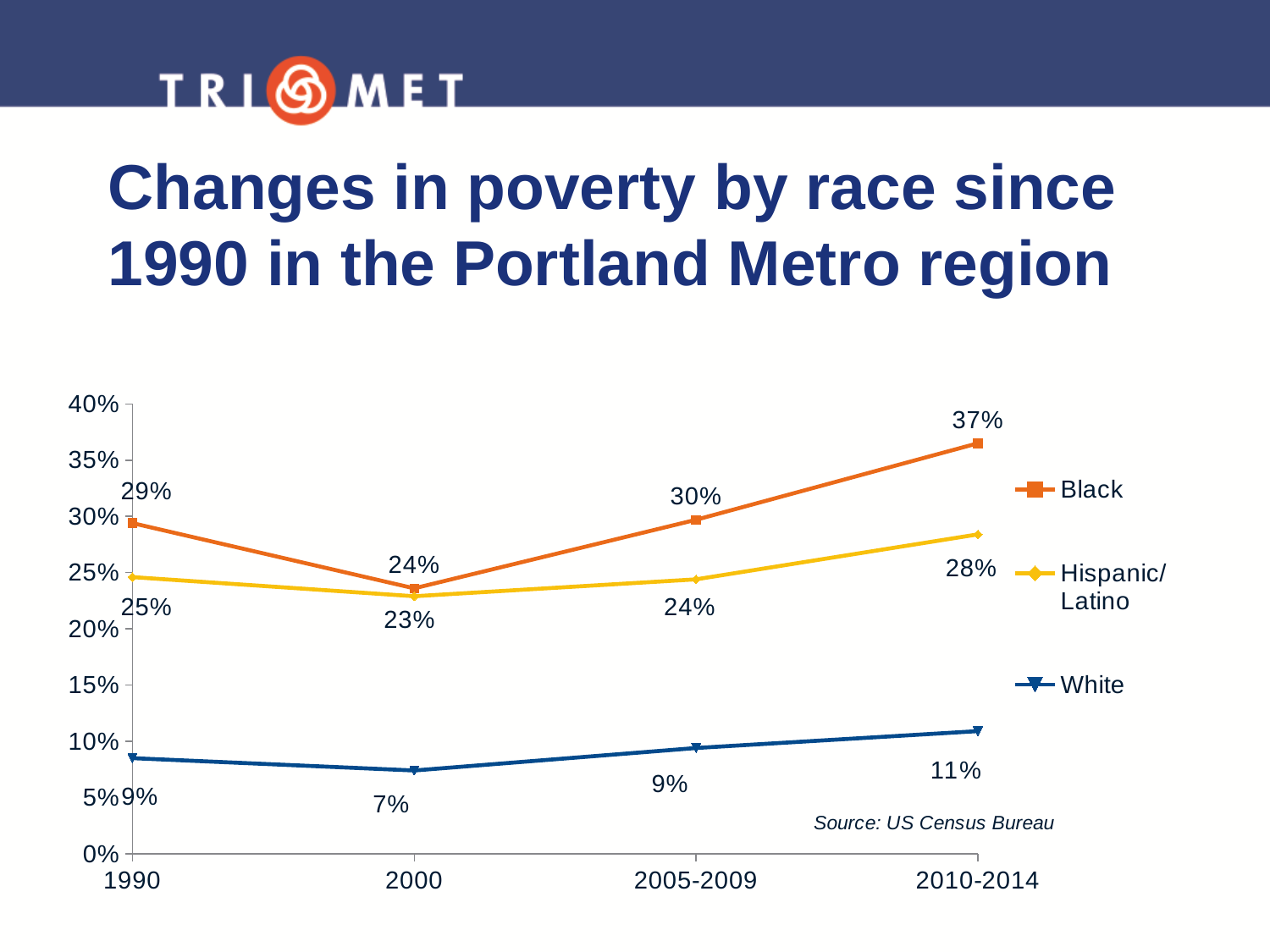
What is the poverty rate for Hispanic/Latino residents in 1990? 25% What source is cited for the chart data? US Census Bureau In which period is the poverty rate for Black residents highest? 2010-2014 What is the difference between the Black and White poverty rates in 2010-2014? 26% What is the poverty rate for Black residents in 2010-2014? 37% What is the poverty rate for White residents in 2000? 7% What kind of chart is shown on the slide? Line chart How many time periods are shown on the x axis? 4 Which group has the higher poverty rate in 2005-2009, Black or Hispanic/Latino? Black In which period is the poverty rate for White residents lowest? 2000 Does the poverty rate for Black residents rise or fall from 2000 to 2010-2014? Rise How many series does the legend list? 3